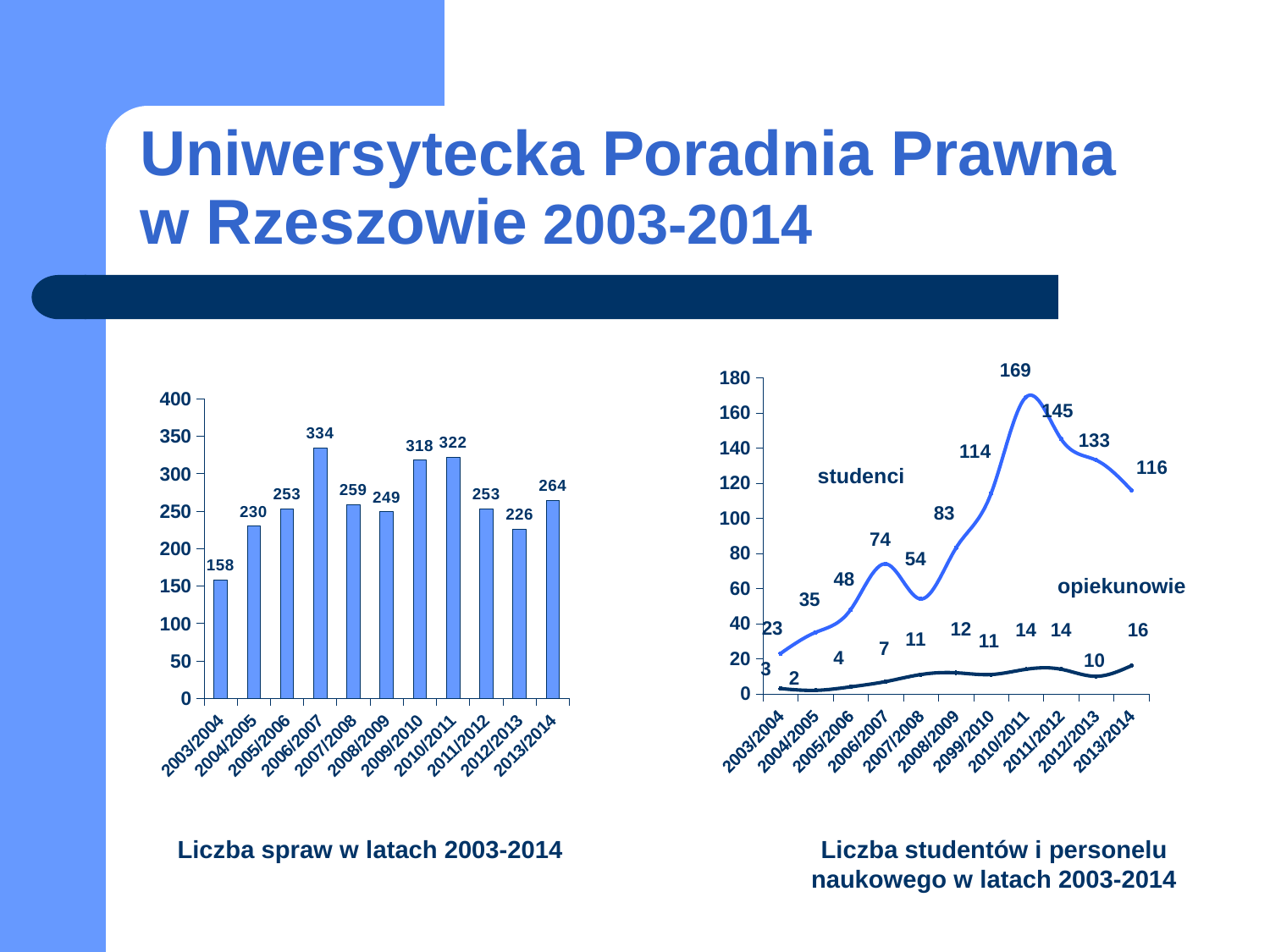
What kind of chart is the right chart (Liczba studentów i personelu naukowego w latach 2003-2014)? line chart In the right chart (Liczba studentów i personelu naukowego w latach 2003-2014), is the value for studenci in 2006/2007 larger or smaller than in 2007/2008? larger In the right chart (Liczba studentów i personelu naukowego w latach 2003-2014), which year has the highest value for studenci? 2010/2011 In the left chart (Liczba spraw w latach 2003-2014), which year has the lowest value? 2003/2004 In the left chart (Liczba spraw w latach 2003-2014), which year has the highest value? 2006/2007 In the left chart (Liczba spraw w latach 2003-2014), how many bars are there? 11 In the right chart (Liczba studentów i personelu naukowego w latach 2003-2014), what is the value for opiekunowie in 2013/2014? 16 In the left chart (Liczba spraw w latach 2003-2014), what is the value for 2006/2007? 334 In the left chart (Liczba spraw w latach 2003-2014), what is the difference between the values for 2010/2011 and 2012/2013? 96 In the right chart (Liczba studentów i personelu naukowego w latach 2003-2014), what is the value for studenci in 2010/2011? 169 What kind of chart is the left chart (Liczba spraw w latach 2003-2014)? bar chart In the right chart (Liczba studentów i personelu naukowego w latach 2003-2014), what is the difference between studenci and opiekunowie in 2011/2012? 131